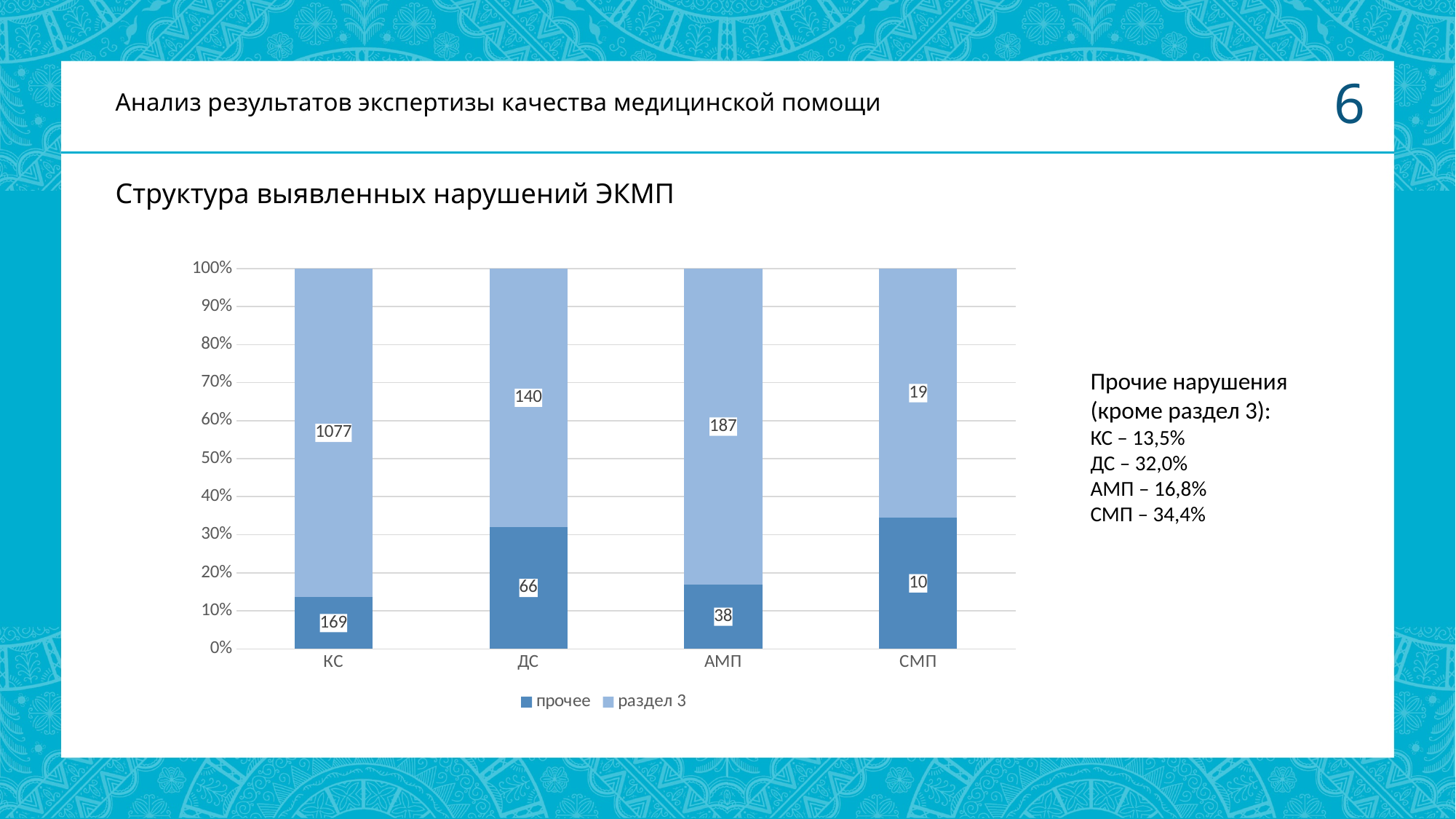
What is the value of 'раздел 3' for КС? 1077 How many categories are shown on the x axis of the chart? 4 Which category has the highest value for 'раздел 3'? КС What is the difference between the 'раздел 3' values for ДС and АМП? 47 What type of chart is shown on the slide? stacked bar chart What is the value of 'прочее' for ДС? 66 What is the value of 'раздел 3' for АМП? 187 What is the value of 'прочее' for СМП? 10 How many series does the chart legend list? 2 Which category has the lowest value for 'прочее'? СМП Which is larger: the 'прочее' value for КС or the 'прочее' value for АМП? КС What is the total of the two series for the ДС bar? 206